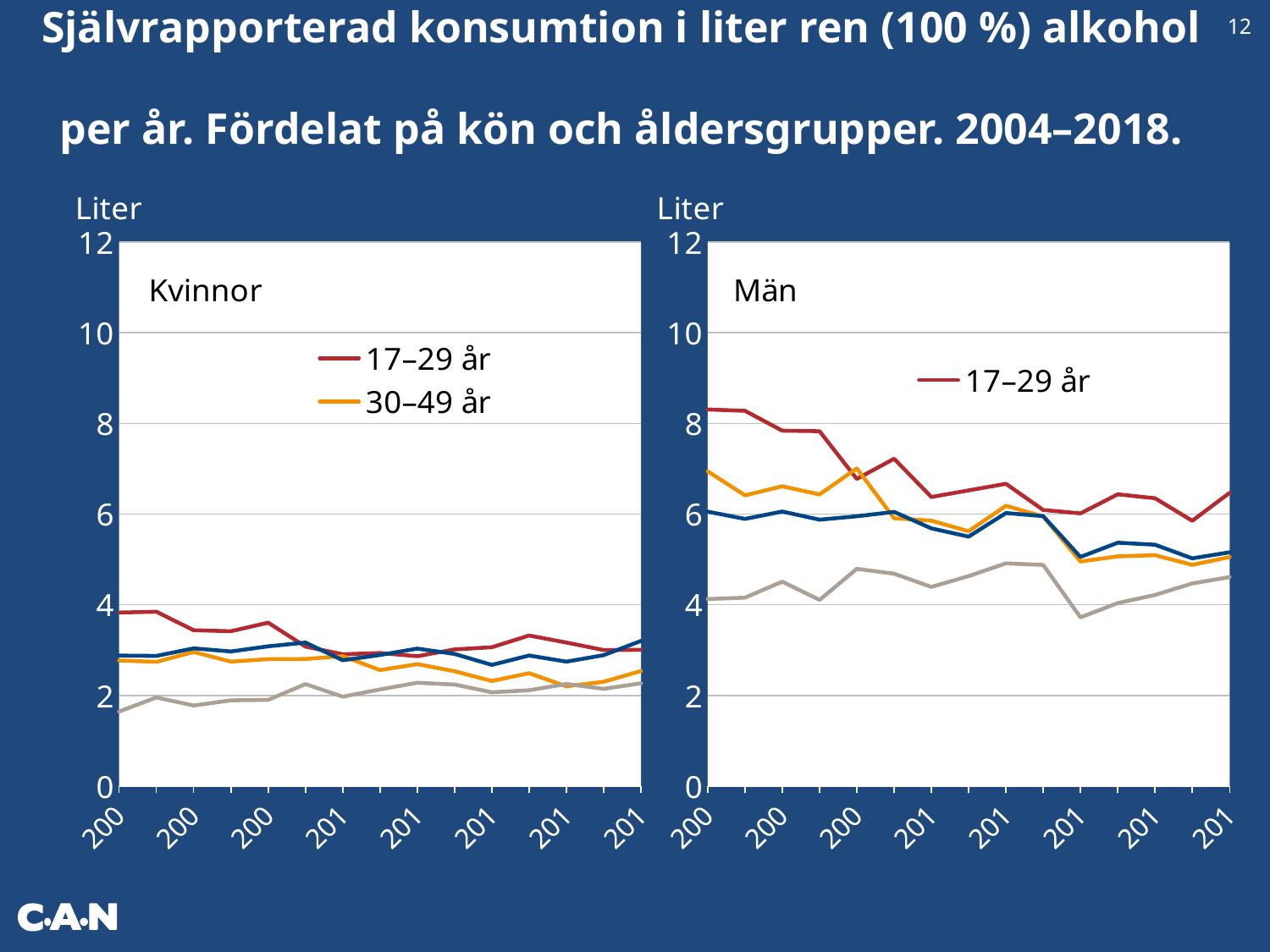
At the start of the period, which is larger: the 17–29 år value in the Män chart or the 17–29 år value in the Kvinnor chart? Män In the Män chart, is the value for 17–29 år at the end of the period greater or less than 8? less How many series does the legend of the Män chart list? 1 What kind of chart is the Kvinnor chart? line chart What unit is shown on the y axis of both charts? Liter What colour is the 17–29 år line in the legend of the Kvinnor chart? red In the Män chart, is the value for 17–29 år at the start of the period greater or less than 8? greater What kind of chart is the Män chart? line chart In the Män chart, does the 17–29 år line generally rise or fall from the start to the end of the period? fall In the Kvinnor chart, is the value for 30–49 år at the end of the period greater or less than 4? less How many series does the legend of the Kvinnor chart list? 2